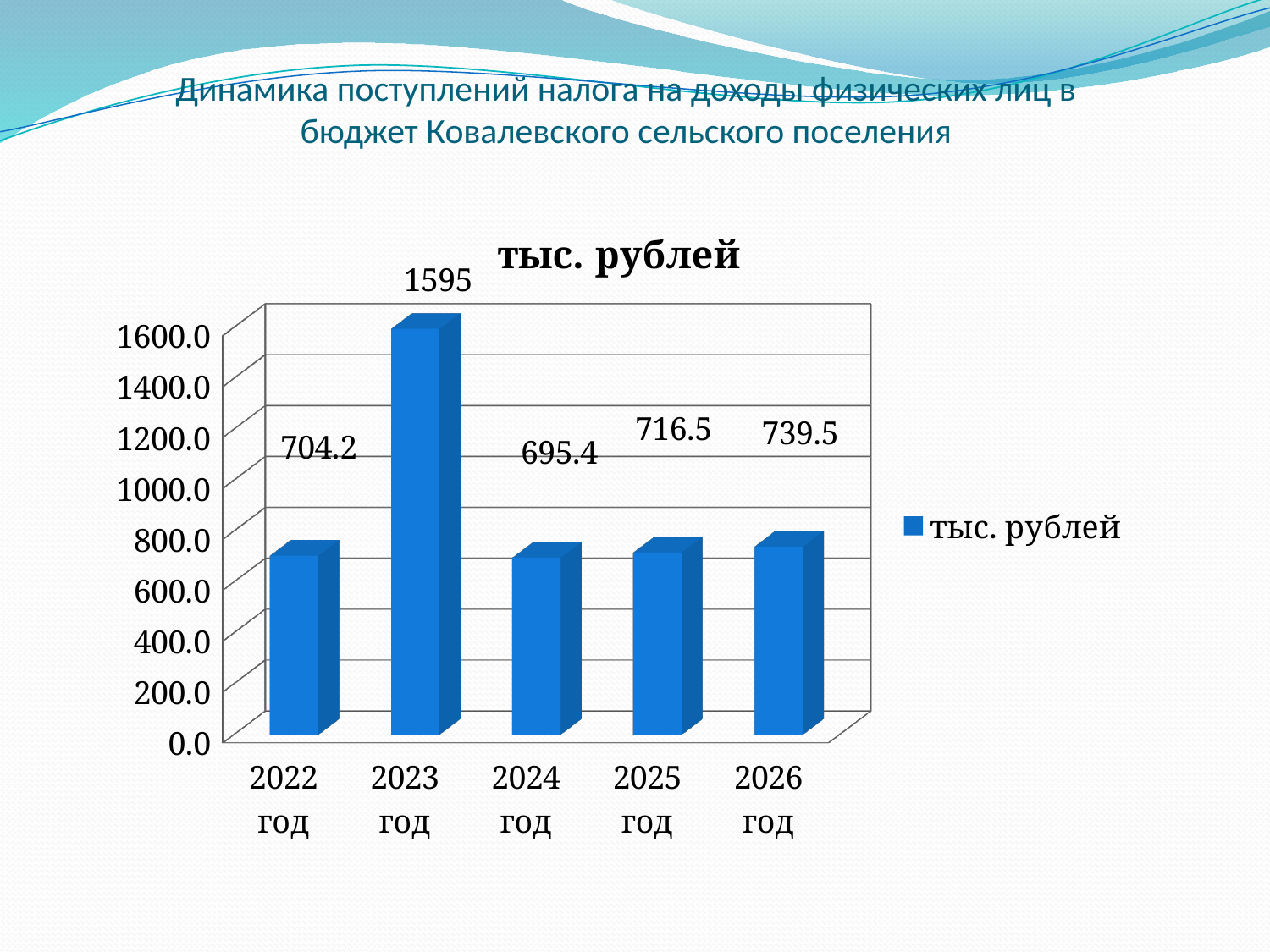
What is the title of the chart? тыс. рублей What is the value for 2022 год? 704.2 How many years are shown on the x axis? 5 What is the value for 2026 год? 739.5 Which year has the lowest value? 2024 год Which year has the highest value? 2023 год Which is larger, the value for 2025 год or the value for 2024 год? 2025 год What kind of chart is shown on the slide? bar chart What is the difference between the values for 2023 год and 2022 год? 890.8 What is the difference between the values for 2026 год and 2025 год? 23.0 What is the value for 2023 год? 1595 Is the value for 2023 год greater or less than 1400.0? greater